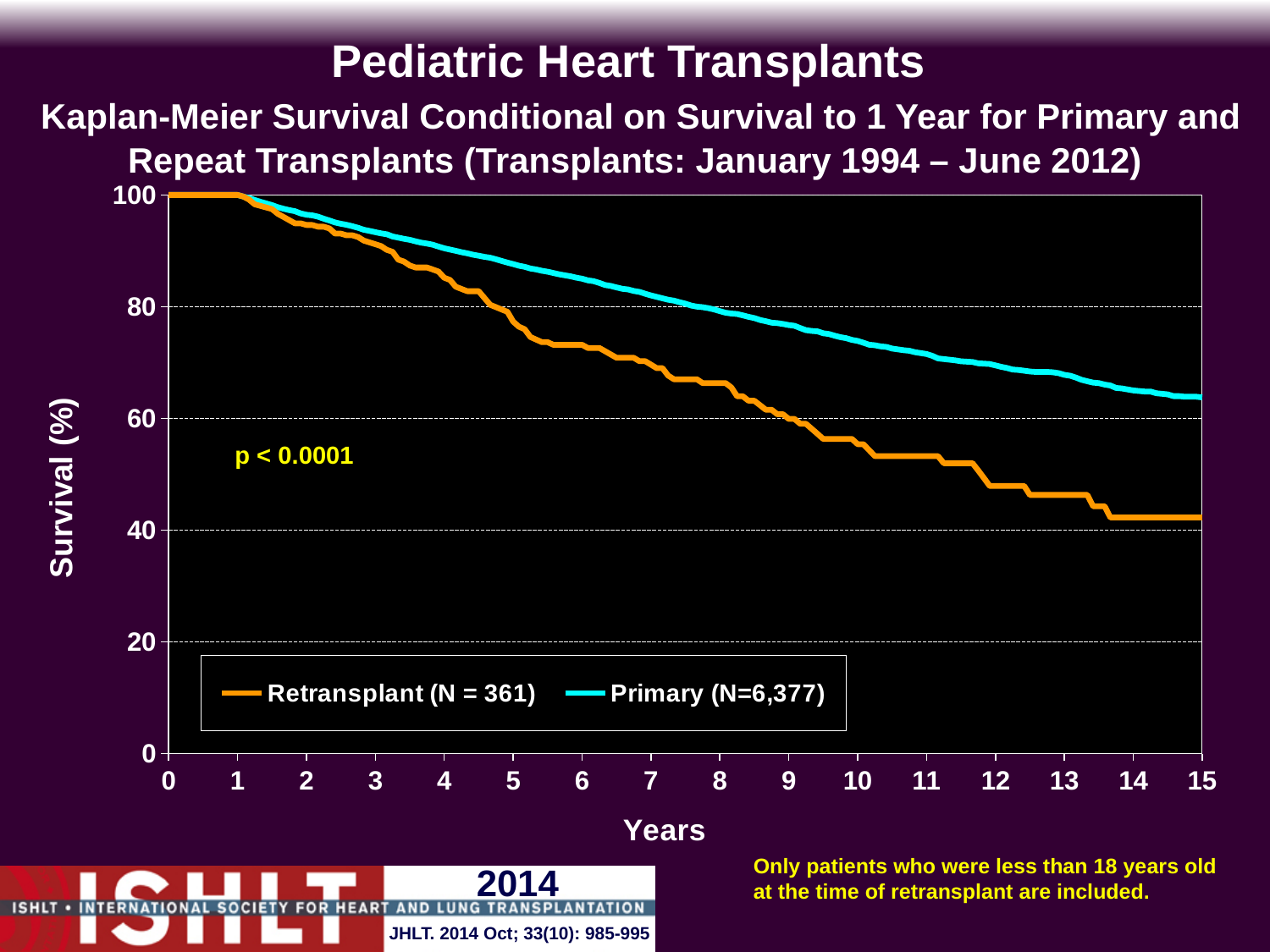
Which series has the lower survival at 15 years? Retransplant (N = 361) Is the survival value for Primary at 15 years greater or less than 60? greater What p-value is printed on the chart? p < 0.0001 At 10 years, which series has the higher survival, Retransplant or Primary? Primary Is the survival value for Retransplant at 5 years greater or less than 80? less Do the survival values rise or fall as the years increase along the x axis? fall Is the survival value for Retransplant at 15 years greater or less than 60? less What is the survival value for both series at year 0? 100 What kind of chart is shown on the slide? line chart How many series does the legend list? 2 What is the N for the Primary series in the legend? 6,377